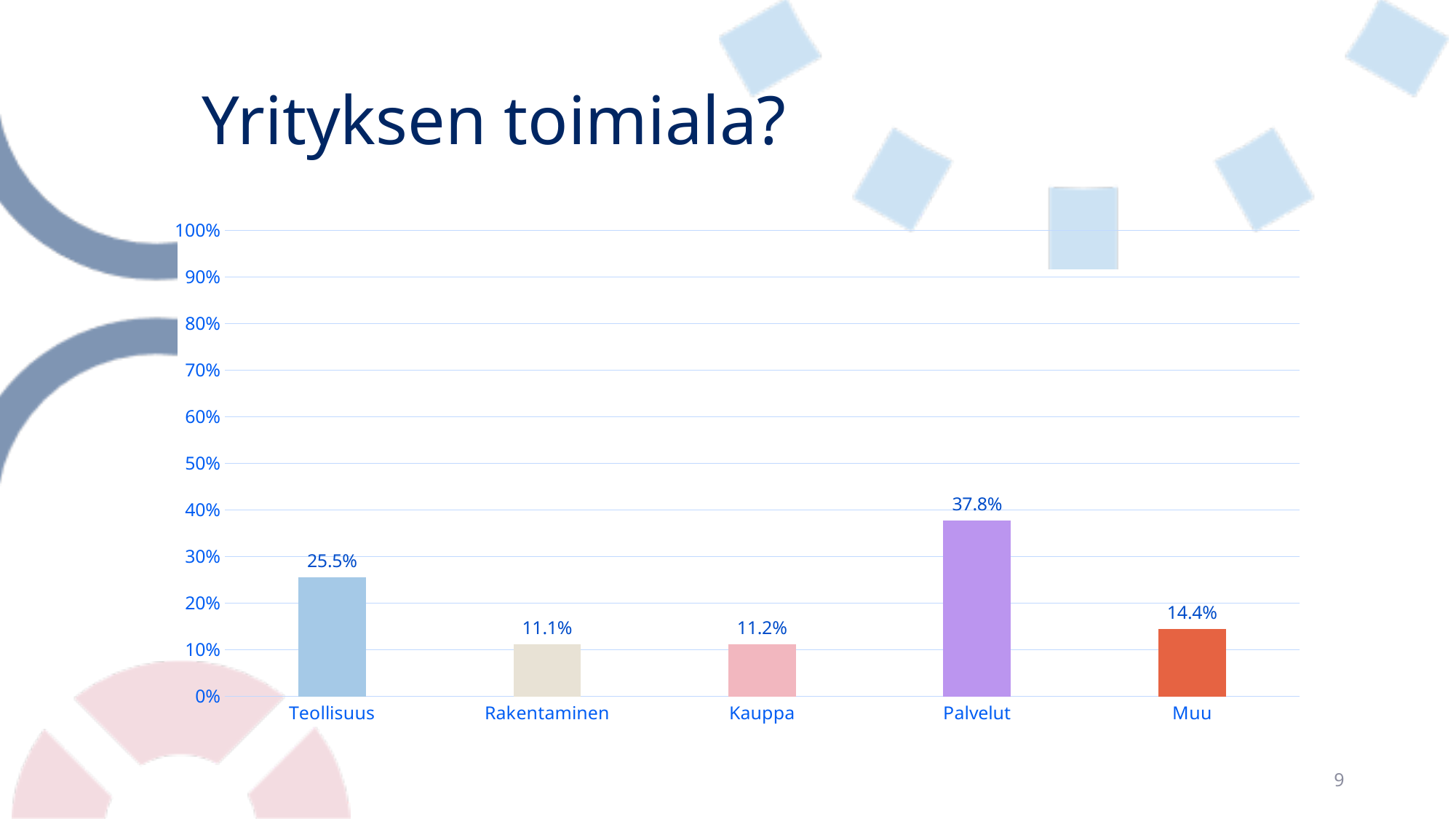
Which category has the lowest value? Rakentaminen What is the value for Muu? 14.4% What is the title of the slide? Yrityksen toimiala? What is the value for Teollisuus? 25.5% What is the difference between the values for Palvelut and Teollisuus? 12.3% Is the value for Palvelut greater or less than 40%? less How many categories are shown on the x axis? 5 What is the value for Palvelut? 37.8% Which category has the highest value? Palvelut What kind of chart is shown on the slide? bar chart Which is larger, the value for Muu or the value for Kauppa? Muu What is the value for Rakentaminen? 11.1%